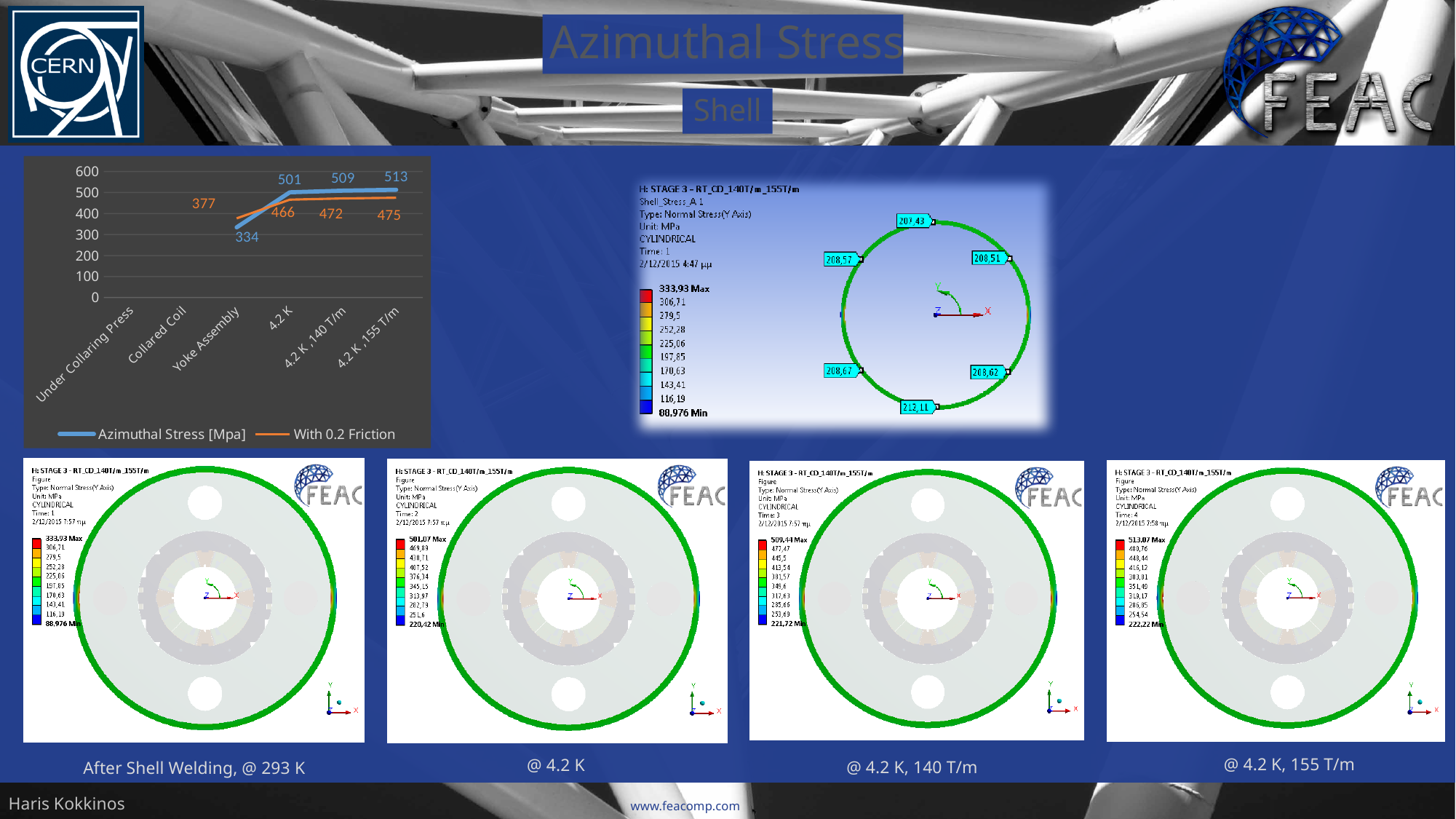
What is the Azimuthal Stress [Mpa] value at Yoke Assembly? 334 What kind of chart is shown on the left of the slide? line chart How many series does the legend of the line chart list? 2 How many categories are on the x axis of the line chart? 6 What is the With 0.2 Friction value at 4.2 K, 140 T/m? 472 What colour is the With 0.2 Friction line in the chart? orange At which category is the Azimuthal Stress [Mpa] series highest? 4.2 K, 155 T/m What is the difference between the Azimuthal Stress [Mpa] and With 0.2 Friction values at 4.2 K, 155 T/m? 38 Does the Azimuthal Stress [Mpa] series rise or fall from 4.2 K to 4.2 K, 155 T/m? rise At 4.2 K, which series has the larger value, Azimuthal Stress [Mpa] or With 0.2 Friction? Azimuthal Stress [Mpa] What is the Azimuthal Stress [Mpa] value at 4.2 K? 501 What is the Azimuthal Stress [Mpa] value at 4.2 K, 155 T/m? 513